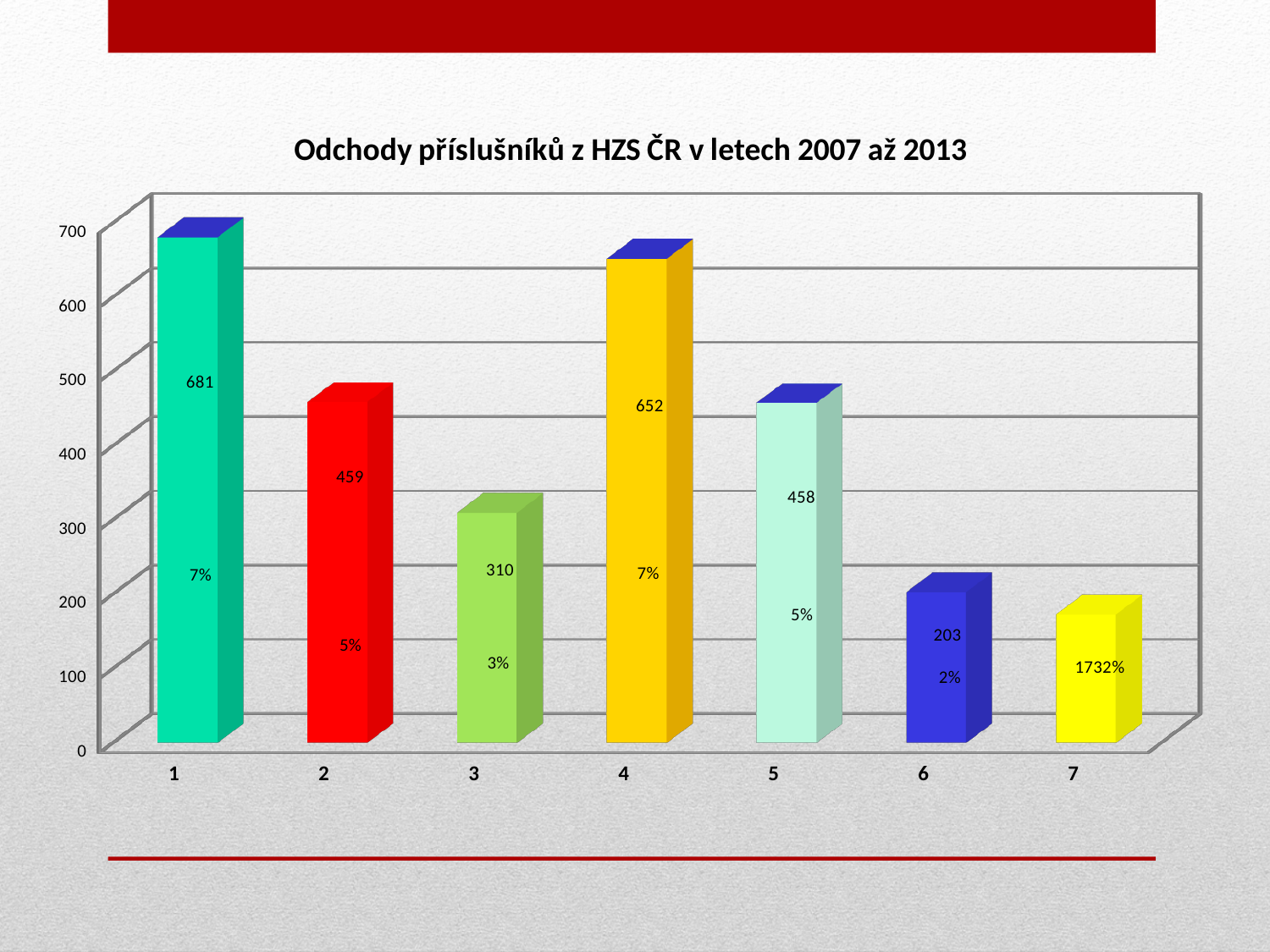
What is the value of the bar for category 3? 310 What is the difference between the values for category 1 and category 4? 29 What percentage is shown on the bar for category 6? 2% What kind of chart is shown on the slide? bar chart Is the value for category 7 greater or less than 200? less What is the difference between the values for category 2 and category 5? 1 Which has the larger value, category 2 or category 5? category 2 What is the value of the bar for category 4? 652 What is the value of the bar for category 1? 681 What is the title of the chart? Odchody příslušníků z HZS ČR v letech 2007 až 2013 Which category has the highest bar? 1 How many categories are shown on the x axis of the chart? 7